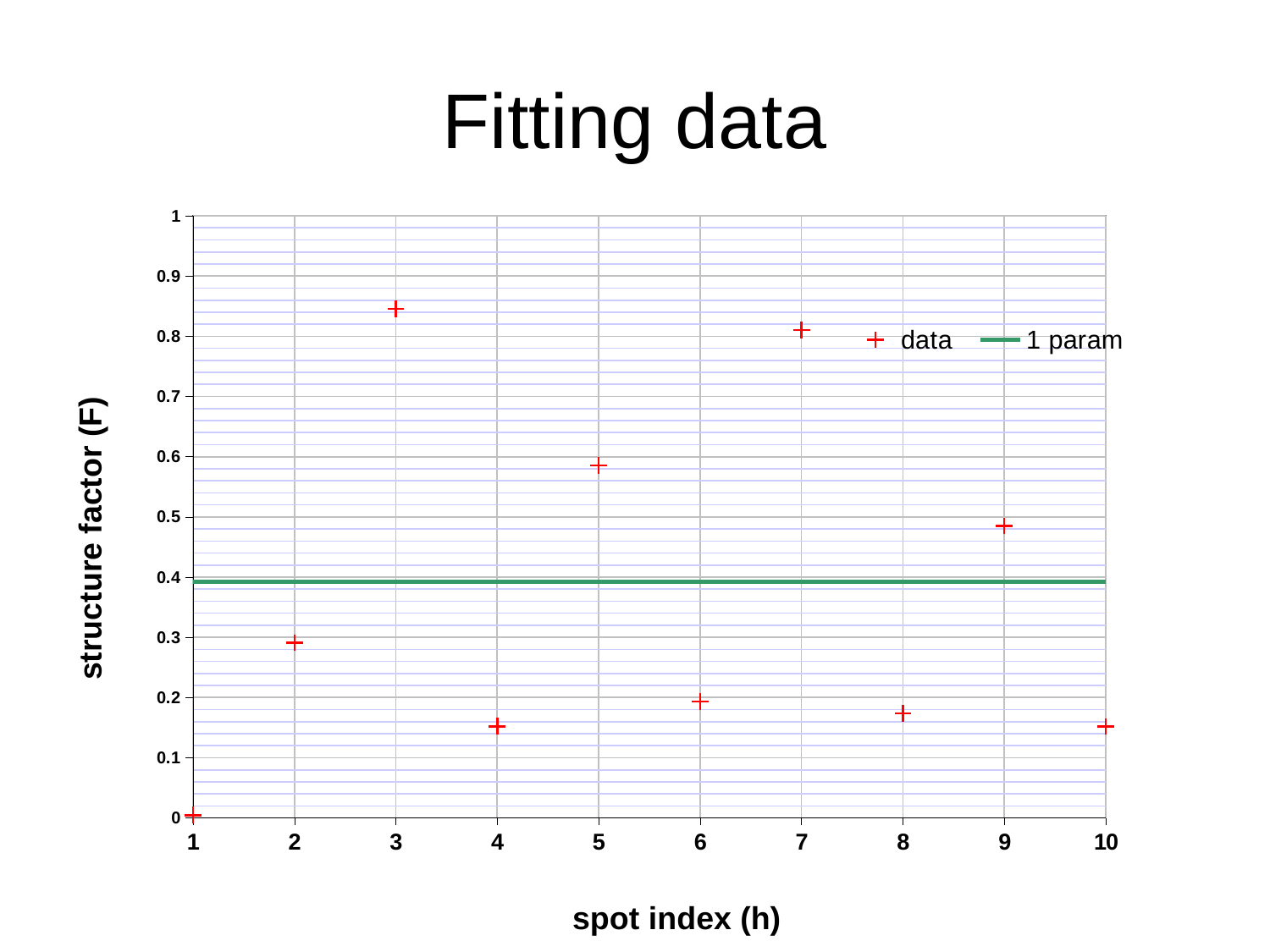
Which is larger, the 'data' value at spot index 5 or at spot index 6? spot index 5 Which spot index has the lowest structure factor in the 'data' series? 1 What kind of chart is shown on the slide? scatter chart Is the 'data' value at spot index 9 greater or less than 0.4? greater What is the label of the x axis? spot index (h) How many series does the legend list? 2 Is the 'data' value at spot index 5 greater or less than 0.5? greater Is the 'data' value at spot index 4 greater or less than 0.2? less How many data points are plotted for the 'data' series? 10 What is the title of the chart? Fitting data